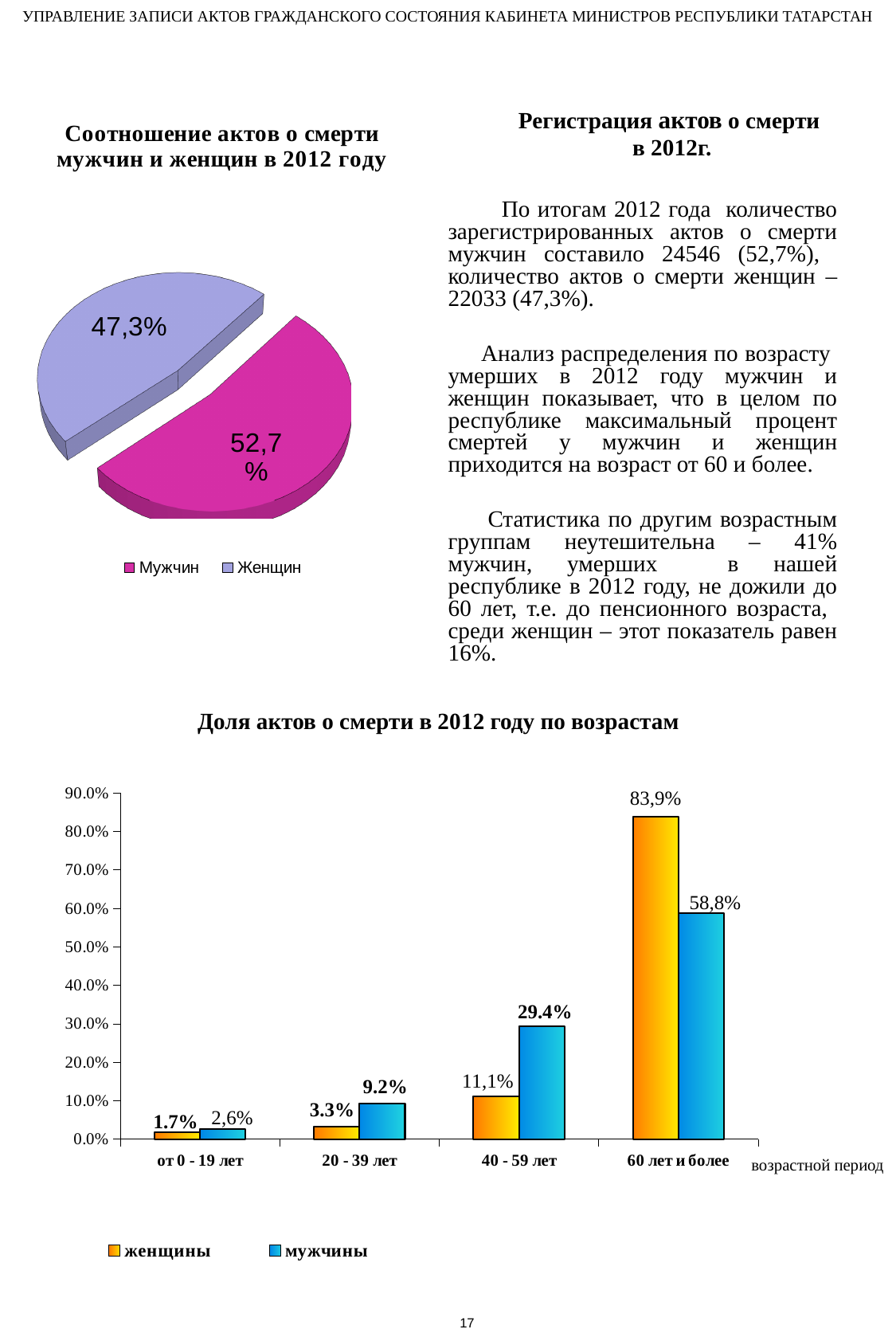
In the bar chart 'Доля актов о смерти в 2012 году по возрастам', what is the value for женщины in the '60 лет и более' category? 83,9% In the pie chart 'Соотношение актов о смерти мужчин и женщин в 2012 году', what share is labelled for Женщин? 47,3% What kind of chart is the one titled 'Соотношение актов о смерти мужчин и женщин в 2012 году'? Pie chart In the bar chart 'Доля актов о смерти в 2012 году по возрастам', how many series does the legend list? 2 In the bar chart 'Доля актов о смерти в 2012 году по возрастам', which age category has the highest value for мужчины? 60 лет и более In the bar chart 'Доля актов о смерти в 2012 году по возрастам', do the values for женщины rise or fall as the age categories move from left to right? Rise In the bar chart 'Доля актов о смерти в 2012 году по возрастам', what is the value for мужчины in the '40 - 59 лет' category? 29.4% In the bar chart 'Доля актов о смерти в 2012 году по возрастам', what is the difference between the мужчины and женщины values in the '20 - 39 лет' category? 5.9% In the pie chart 'Соотношение актов о смерти мужчин и женщин в 2012 году', which slice is larger, Мужчин or Женщин? Мужчин In the pie chart 'Соотношение актов о смерти мужчин и женщин в 2012 году', what share is labelled for Мужчин? 52,7% What kind of chart is the one titled 'Доля актов о смерти в 2012 году по возрастам'? Bar chart In the bar chart 'Доля актов о смерти в 2012 году по возрастам', how many age categories are shown on the x axis? 4